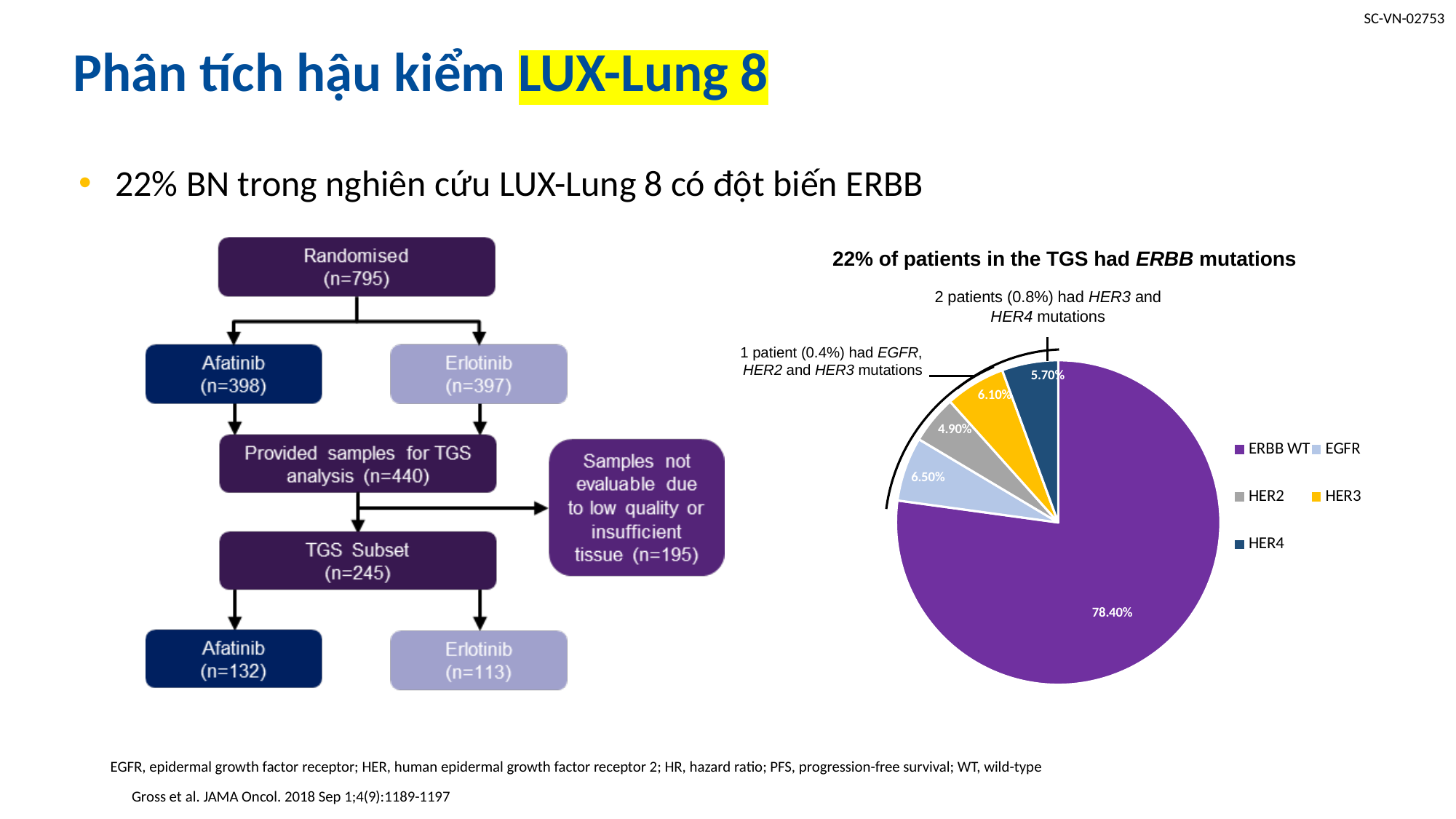
In the pie chart, what share of patients is labelled ERBB WT? 78.40% What is the difference in percentage points between the EGFR and HER2 slices in the pie chart? 1.60% In the pie chart, what percentage is shown for HER4? 5.70% What is the title of the pie chart? 22% of patients in the TGS had ERBB mutations What type of chart is shown on the right side of the slide? pie chart Which slice of the pie chart is the largest? ERBB WT How many categories does the legend of the pie chart list? 5 In the pie chart, what percentage is shown for HER3? 6.10% In the pie chart, what percentage is shown for HER2? 4.90% In the pie chart, what percentage is shown for EGFR? 6.50% Which slice of the pie chart is the smallest? HER2 In the pie chart, which is larger, the EGFR slice or the HER4 slice? EGFR